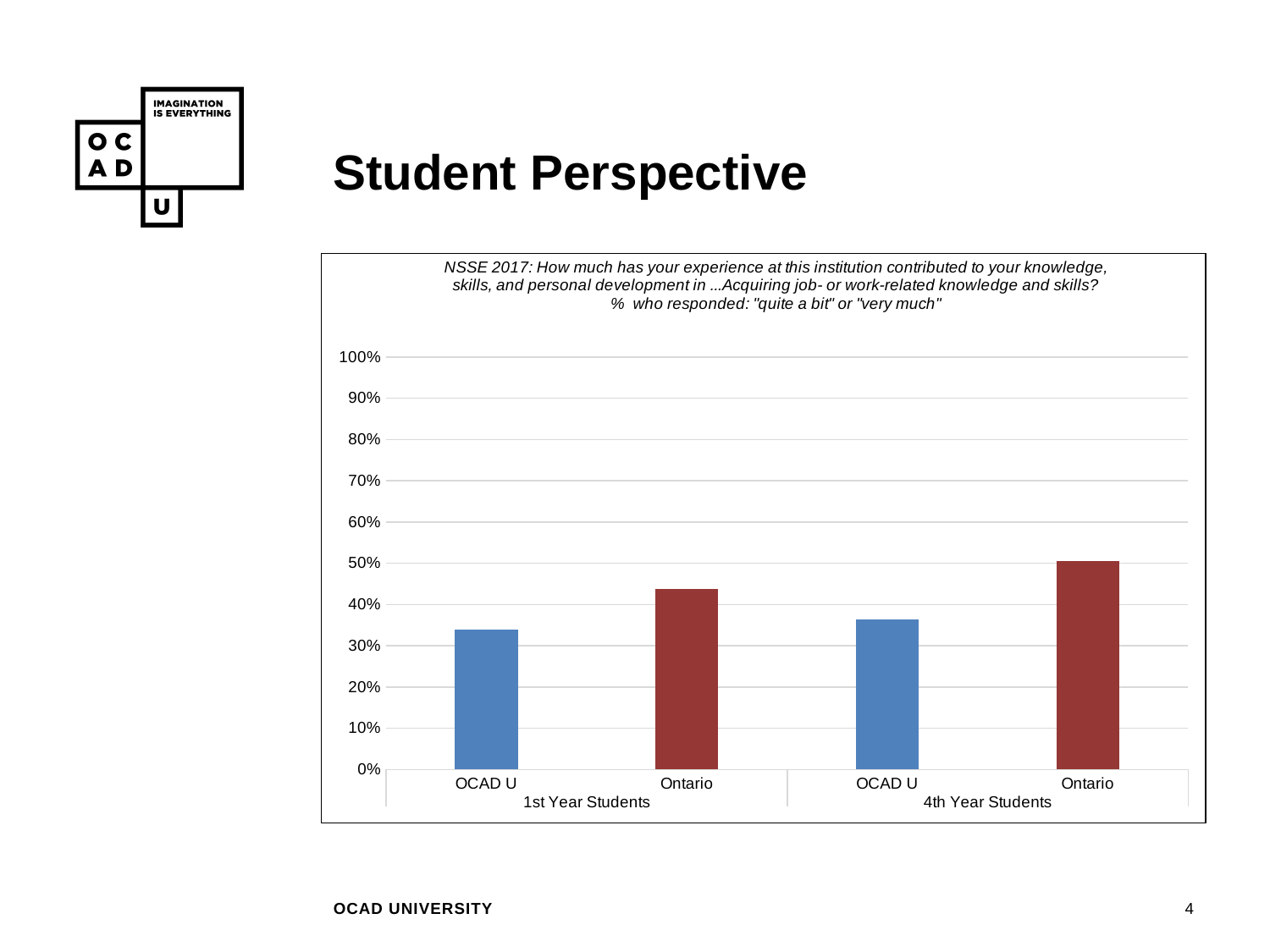
How many bars are plotted in the chart? 4 What kind of chart is shown on the slide? bar chart Which survey and year is named in the chart title? NSSE 2017 Is the value for OCAD U among 1st Year Students greater or less than 40%? less Is the value for Ontario among 4th Year Students greater or less than 40%? greater Is the value for Ontario among 4th Year Students greater or less than 60%? less Which is larger: Ontario among 1st Year Students or Ontario among 4th Year Students? Ontario among 4th Year Students Which bar is the highest in the chart? Ontario, 4th Year Students Among 1st Year Students, which is larger: OCAD U or Ontario? Ontario How many student-year groups are shown on the x axis? 2